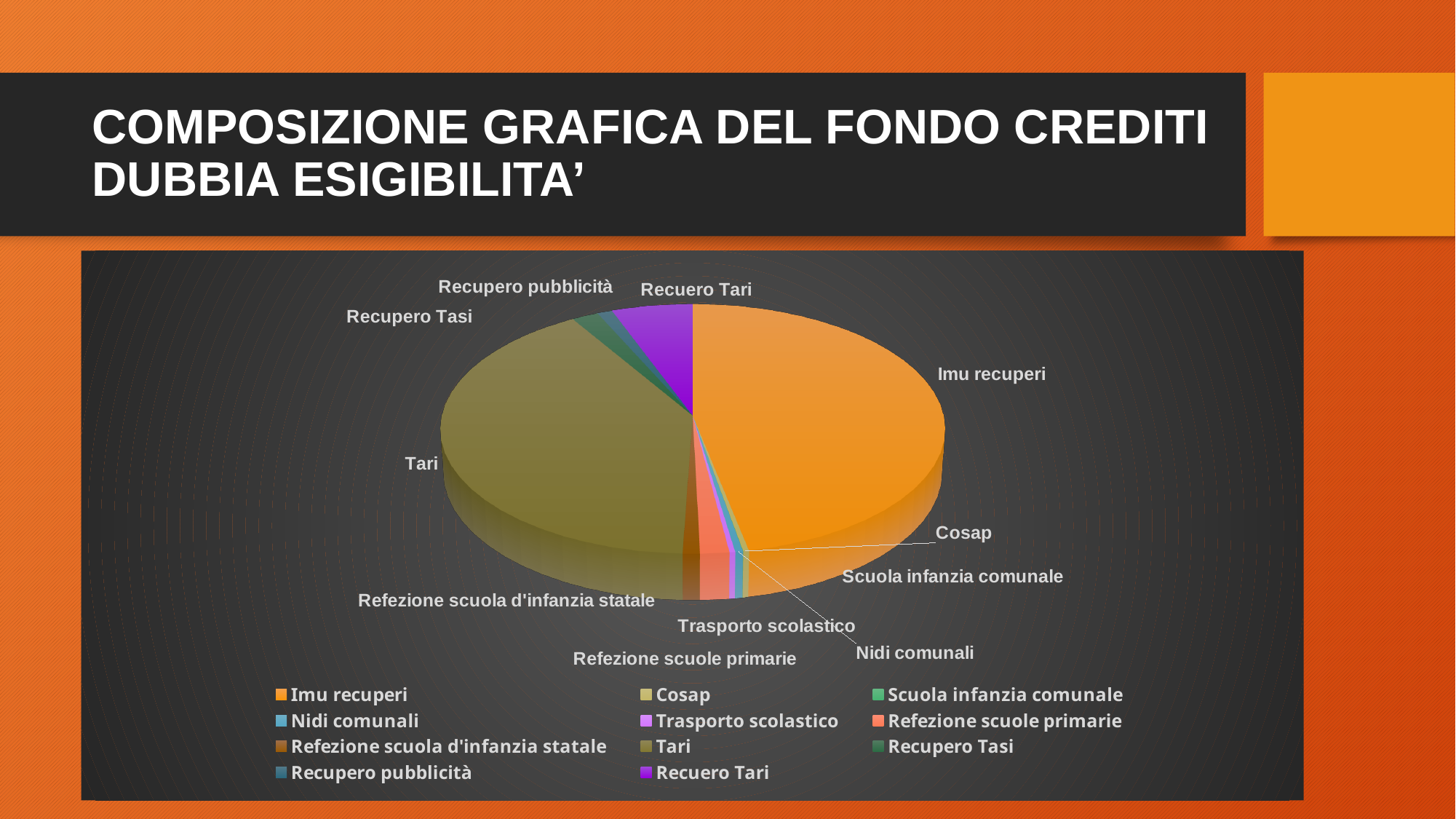
How many entries does the legend of the pie chart list? 11 Which is larger in the pie chart, the slice for Tari or the slice for Recuero Tari? Tari Which is larger in the pie chart, the slice for Tari or the slice for Recupero Tasi? Tari Which is larger in the pie chart, the slice for Imu recuperi or the slice for Nidi comunali? Imu recuperi What colour is the Recuero Tari slice in the pie chart? purple How many categories (slices) does the pie chart have? 11 What is the title of the slide containing the pie chart? COMPOSIZIONE GRAFICA DEL FONDO CREDITI DUBBIA ESIGIBILITA' What kind of chart is shown on the slide? pie chart